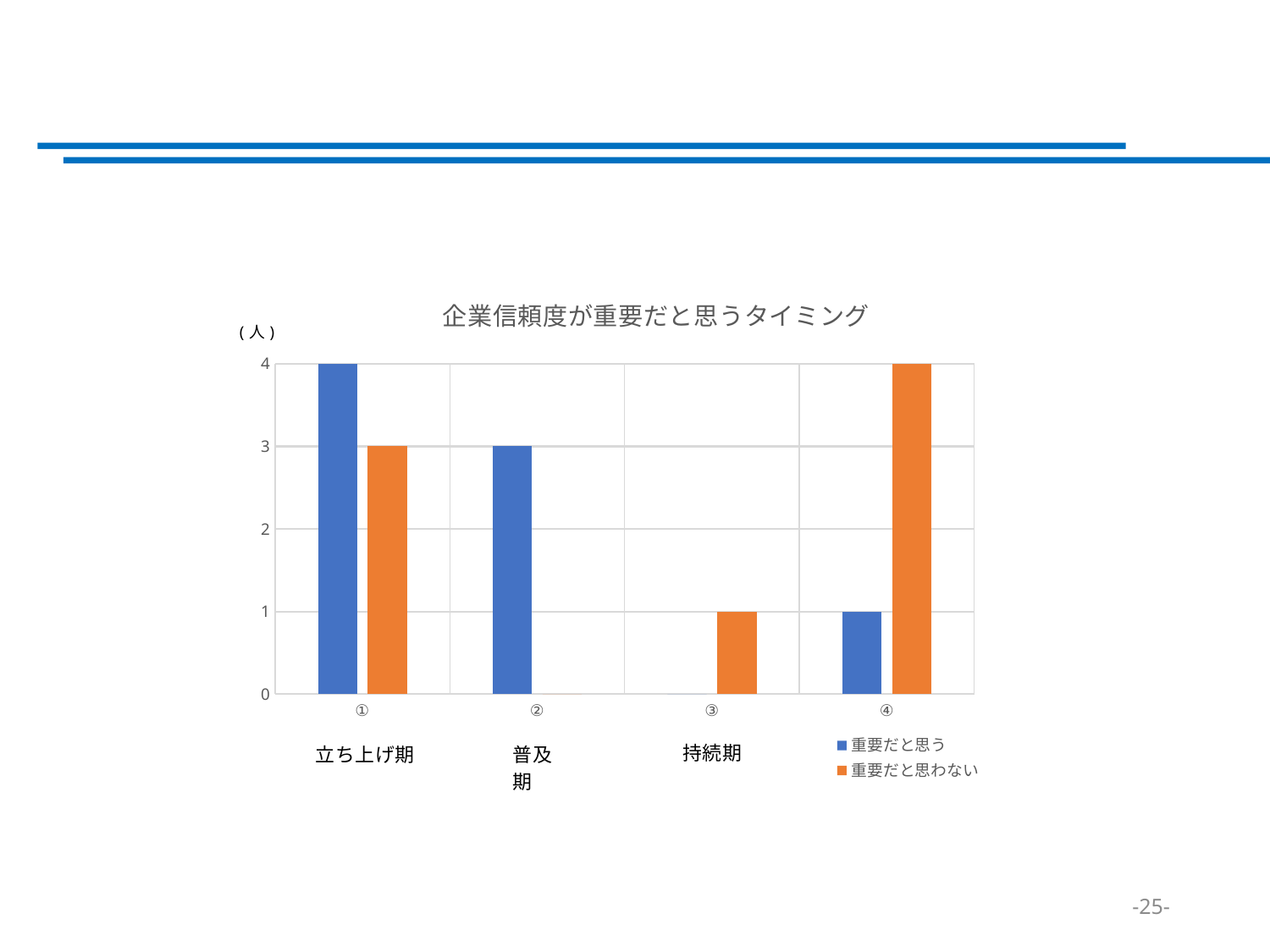
Which category has the highest value for 重要だと思わない? ④ What is the value of 重要だと思わない for category ④? 4 What is the title of the chart? 企業信頼度が重要だと思うタイミング How many categories are shown on the x axis? 4 For category ④, which is larger: 重要だと思う or 重要だと思わない? 重要だと思わない What is the value of 重要だと思う for category ①? 4 Which category has the highest value for 重要だと思う? ① How many series does the legend list? 2 What is the difference between 重要だと思う and 重要だと思わない for category ①? 1 What is the value of 重要だと思わない for category ③? 1 What is the value of 重要だと思う for category ②? 3 What type of chart is shown on the slide? bar chart